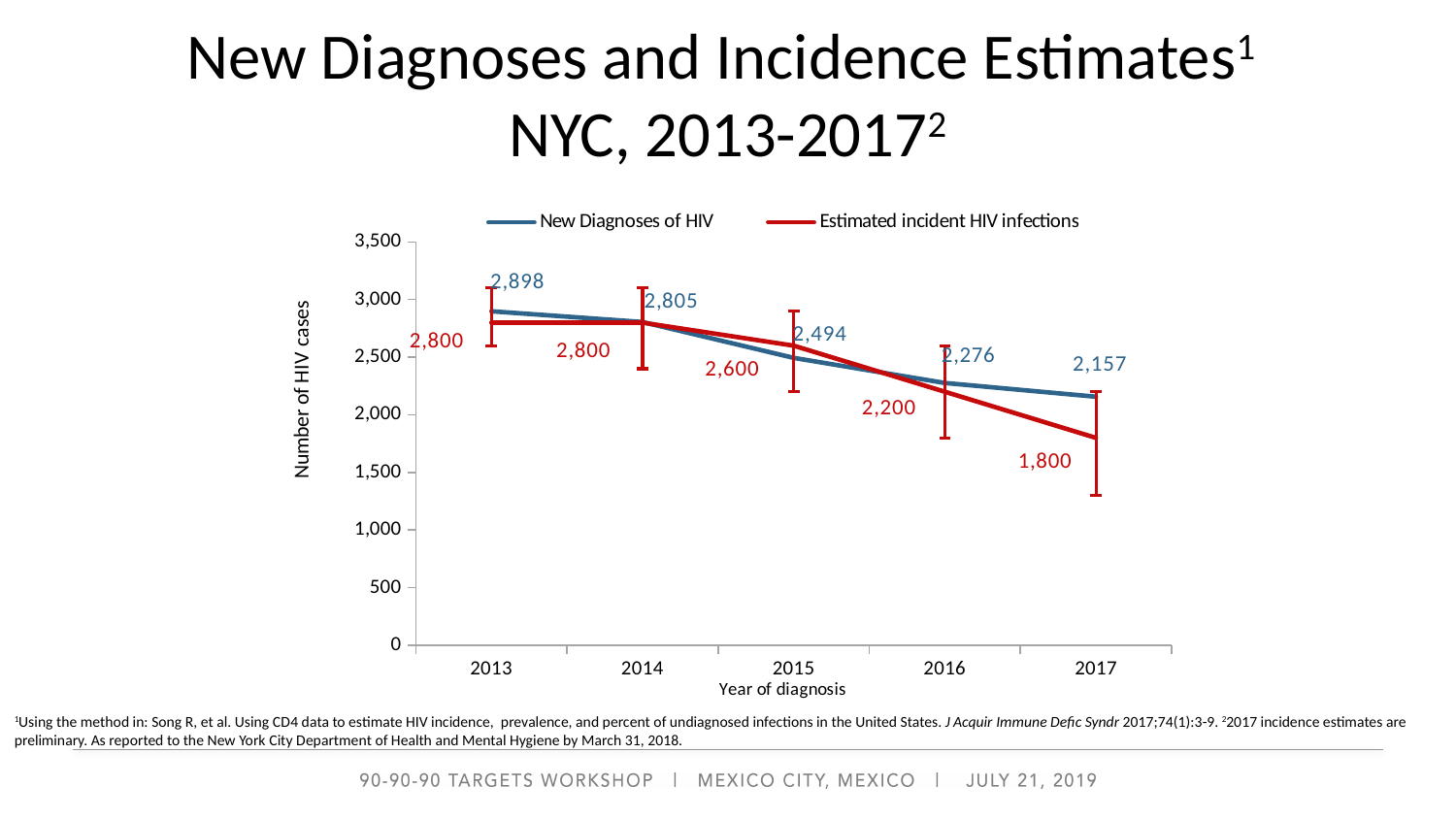
What is the value for New Diagnoses of HIV in 2013? 2,898 What is the value for Estimated incident HIV infections in 2017? 1,800 How many years are plotted on the x axis? 5 What is the value for New Diagnoses of HIV in 2015? 2,494 In which year is the number of New Diagnoses of HIV highest? 2013 How many series does the legend list? 2 What is the label of the y axis? Number of HIV cases Which is larger in 2017: New Diagnoses of HIV or Estimated incident HIV infections? New Diagnoses of HIV What is the difference between New Diagnoses of HIV in 2013 and in 2017? 741 In which year is the number of Estimated incident HIV infections lowest? 2017 Do the values for Estimated incident HIV infections rise or fall from 2014 to 2017? Fall What type of chart is shown on the slide? Line chart